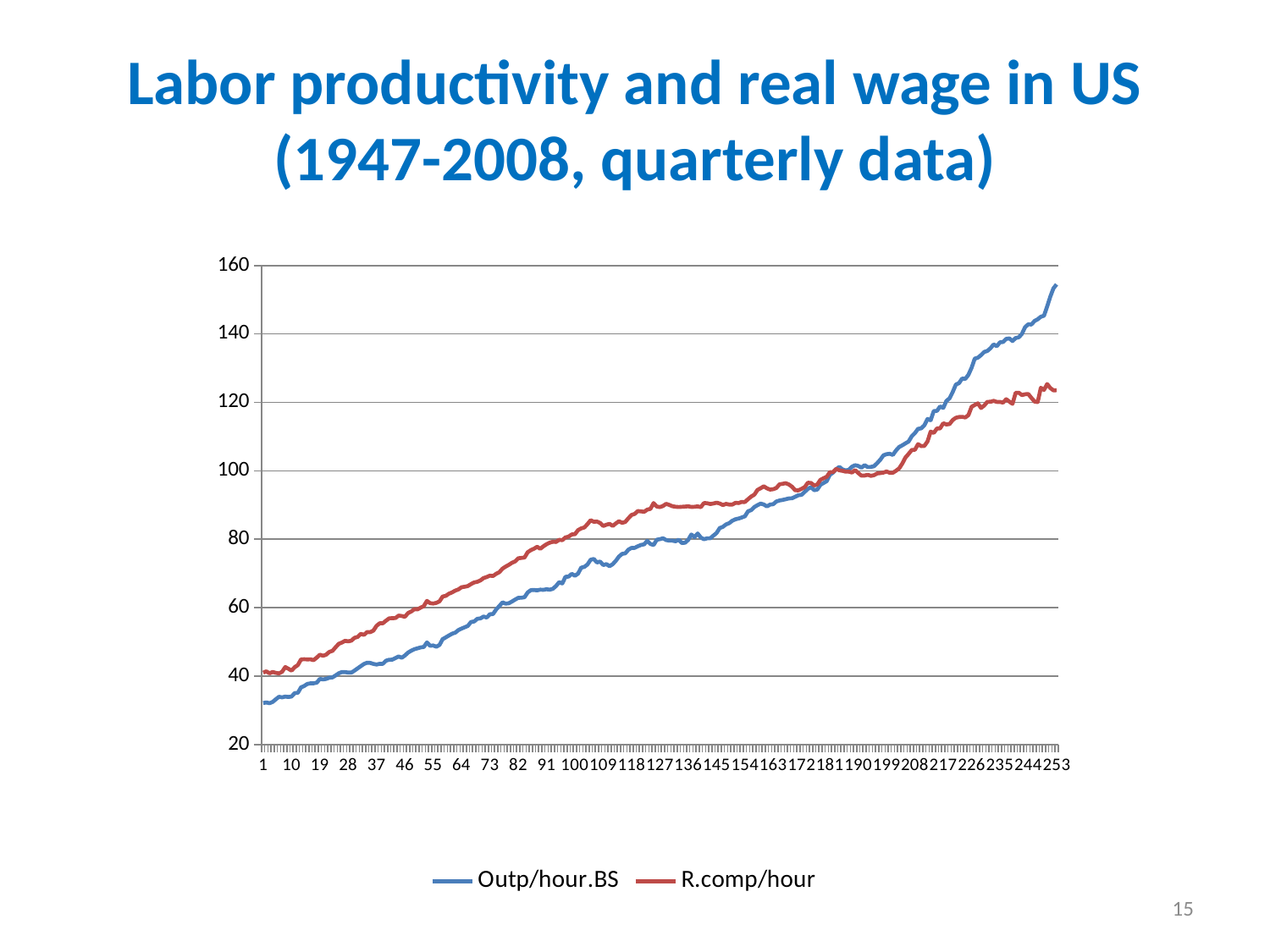
Is the value of R.comp/hour at x = 253 greater or less than 140? less Does the R.comp/hour series generally rise or fall along the x axis? rise Which colour is used for the R.comp/hour series? red Is the value of Outp/hour.BS at x = 100 greater or less than 80? less At x = 253, which series has the higher value, Outp/hour.BS or R.comp/hour? Outp/hour.BS Does the Outp/hour.BS series generally rise or fall along the x axis? rise Is the value of Outp/hour.BS at x = 1 greater or less than 40? less What kind of chart is shown on the slide? line chart At x = 100, which series has the higher value, Outp/hour.BS or R.comp/hour? R.comp/hour How many series does the legend list? 2 What are the two series named in the legend? Outp/hour.BS and R.comp/hour